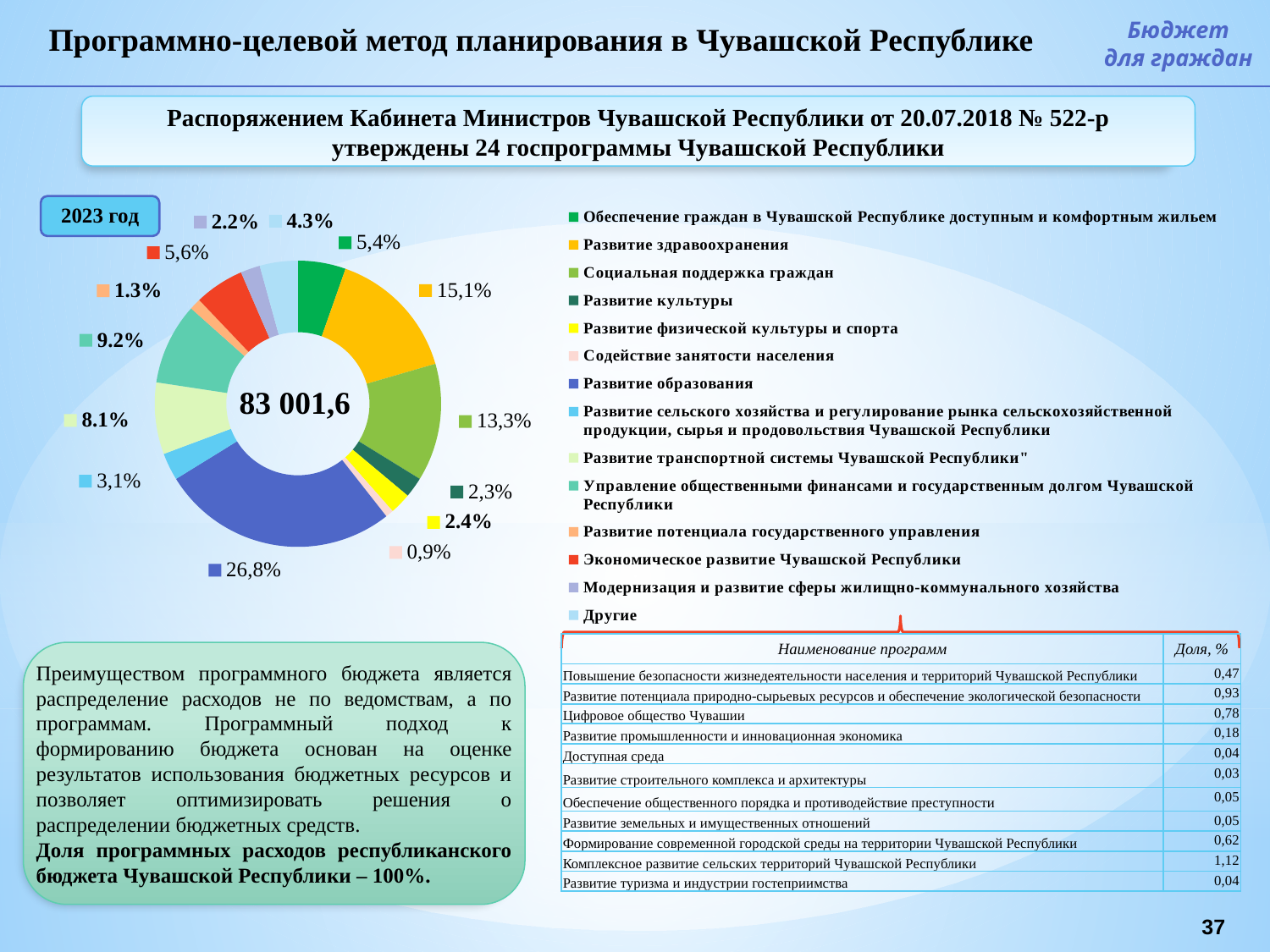
What value is printed in the centre of the doughnut chart? 83 001,6 What share does Развитие здравоохранения have in the chart? 15,1% What type of chart is shown on the slide? Doughnut (pie) chart What share does Содействие занятости населения have in the chart? 0,9% What share does Социальная поддержка граждан have in the chart? 13,3% What share does Развитие образования have in the chart? 26,8% Which program has the smallest share in the chart? Содействие занятости населения What share does Экономическое развитие Чувашской Республики have in the chart? 5,6% By how many percentage points does Развитие здравоохранения exceed Социальная поддержка граждан? 1,8 Which program has the largest share in the chart? Развитие образования Which has a larger share: Управление общественными финансами и государственным долгом or Развитие транспортной системы? Управление общественными финансами и государственным долгом How many slices does the doughnut chart have? 14